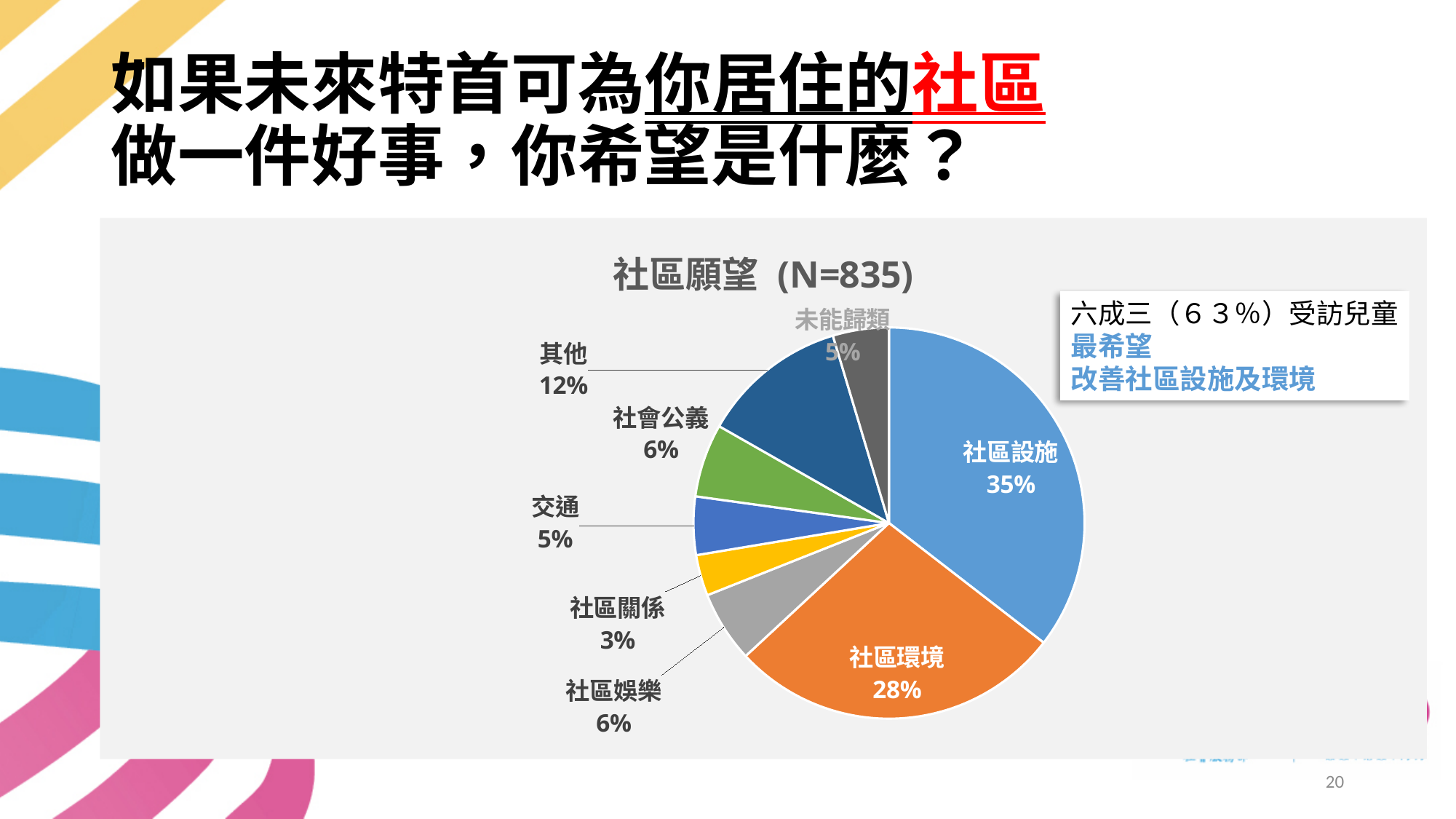
What percentage of the pie is 其他? 12% What is the title of the chart? 社區願望 (N=835) Which category has the smallest share of the pie? 社區關係 What percentage of the pie is 交通? 5% Which is larger, the share for 其他 or the share for 社會公義? 其他 What kind of chart is shown on the slide? pie chart What is the difference in percentage points between 社區設施 and 社區環境? 7 What percentage of the pie is 社區關係? 3% What percentage of the pie is 社區環境? 28% What percentage of the pie is 社區設施? 35% How many slices does the pie chart have? 8 Which category has the largest share of the pie? 社區設施